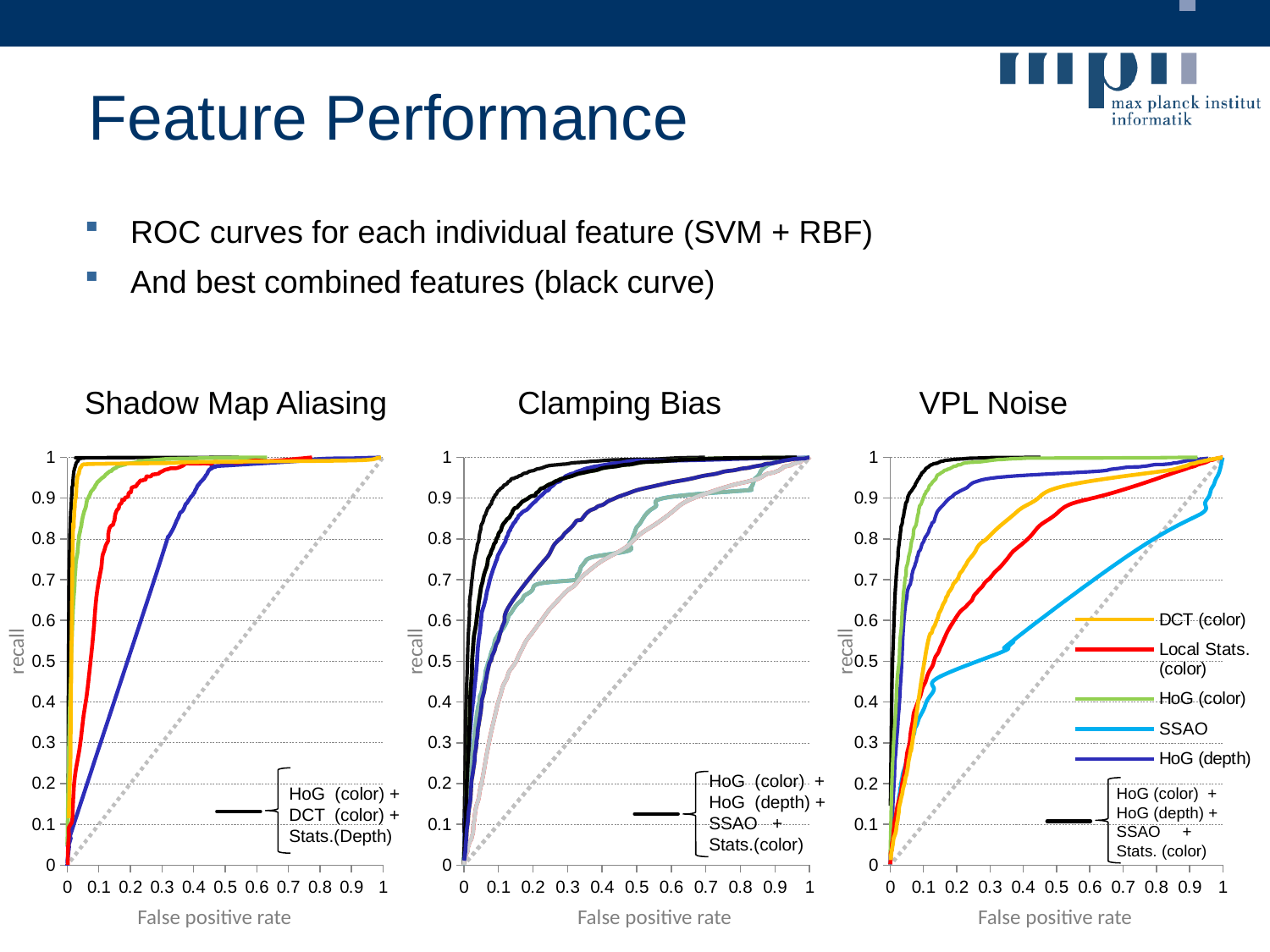
In the VPL Noise chart, at a false positive rate of 0.5, which curve has the higher recall: DCT (color) or SSAO? DCT (color) In the VPL Noise chart, does the recall of the SSAO curve rise or fall as the false positive rate increases? rise In the Shadow Map Aliasing chart, is the recall of the red curve at a false positive rate of 0.1 greater or less than 0.5? greater What is the label of the x axis on the Clamping Bias chart? False positive rate In the VPL Noise chart, is the recall of the HoG (color) curve at a false positive rate of 0.1 greater or less than 0.9? greater In the VPL Noise chart, is the recall of the SSAO curve at a false positive rate of 0.1 greater or less than 0.5? less What is the label of the y axis on the VPL Noise chart? recall What kind of chart is the Shadow Map Aliasing chart? line chart How many feature series does the legend on the VPL Noise chart list (excluding the black combined curve)? 5